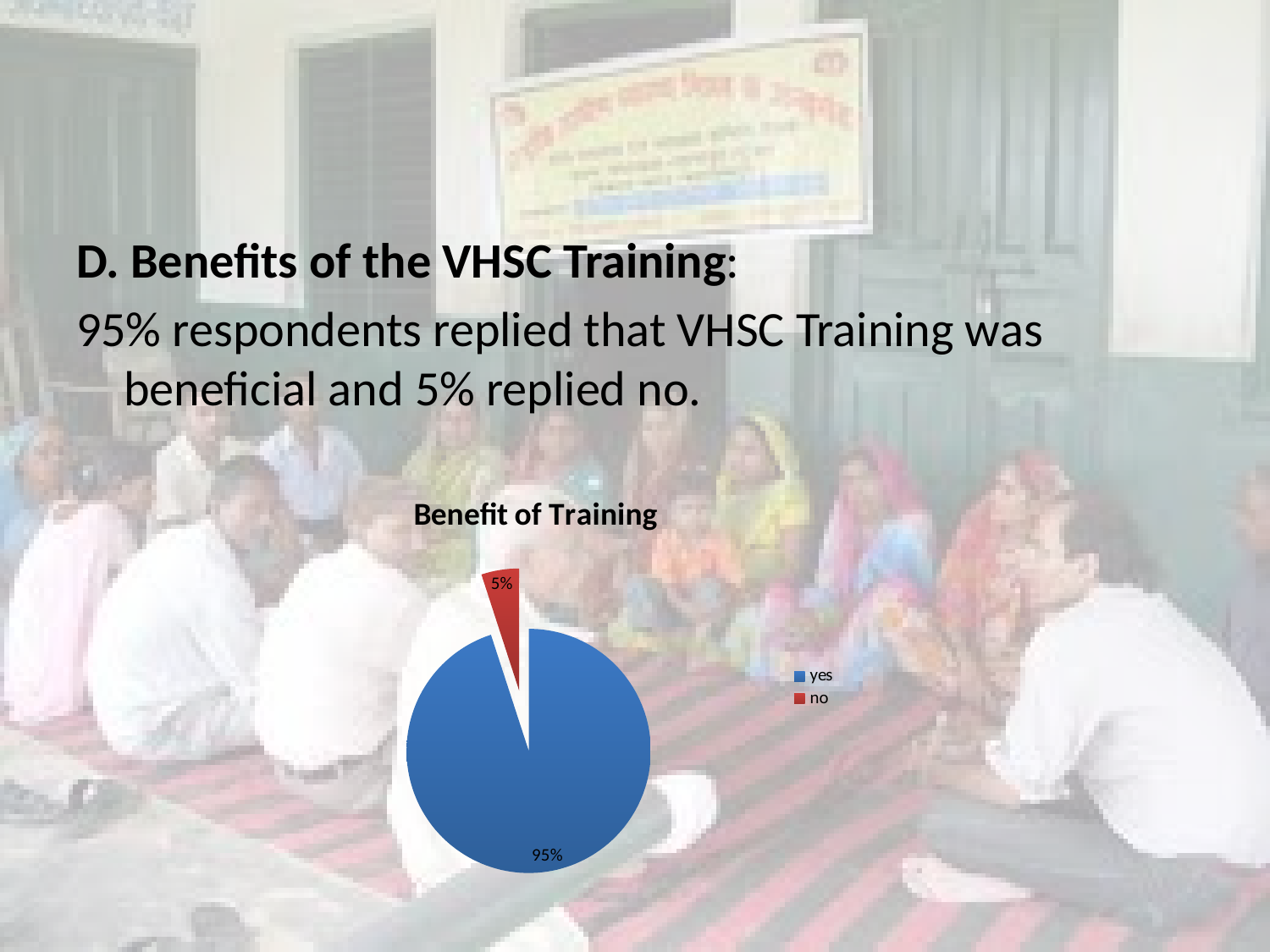
What is the title of the chart? Benefit of Training What is the difference in percentage points between the 'yes' and 'no' slices? 90 percentage points Which category has the largest slice of the pie? yes What share of the pie does the 'no' slice represent? 5% What share of the pie does the 'yes' slice represent? 95% How many categories does the pie chart show? 2 Which category has the smallest slice of the pie? no Which is larger, the 'yes' slice or the 'no' slice? yes How many entries does the legend list? 2 What type of chart is shown on the slide? pie chart What colour is the 'no' slice in the pie chart? red